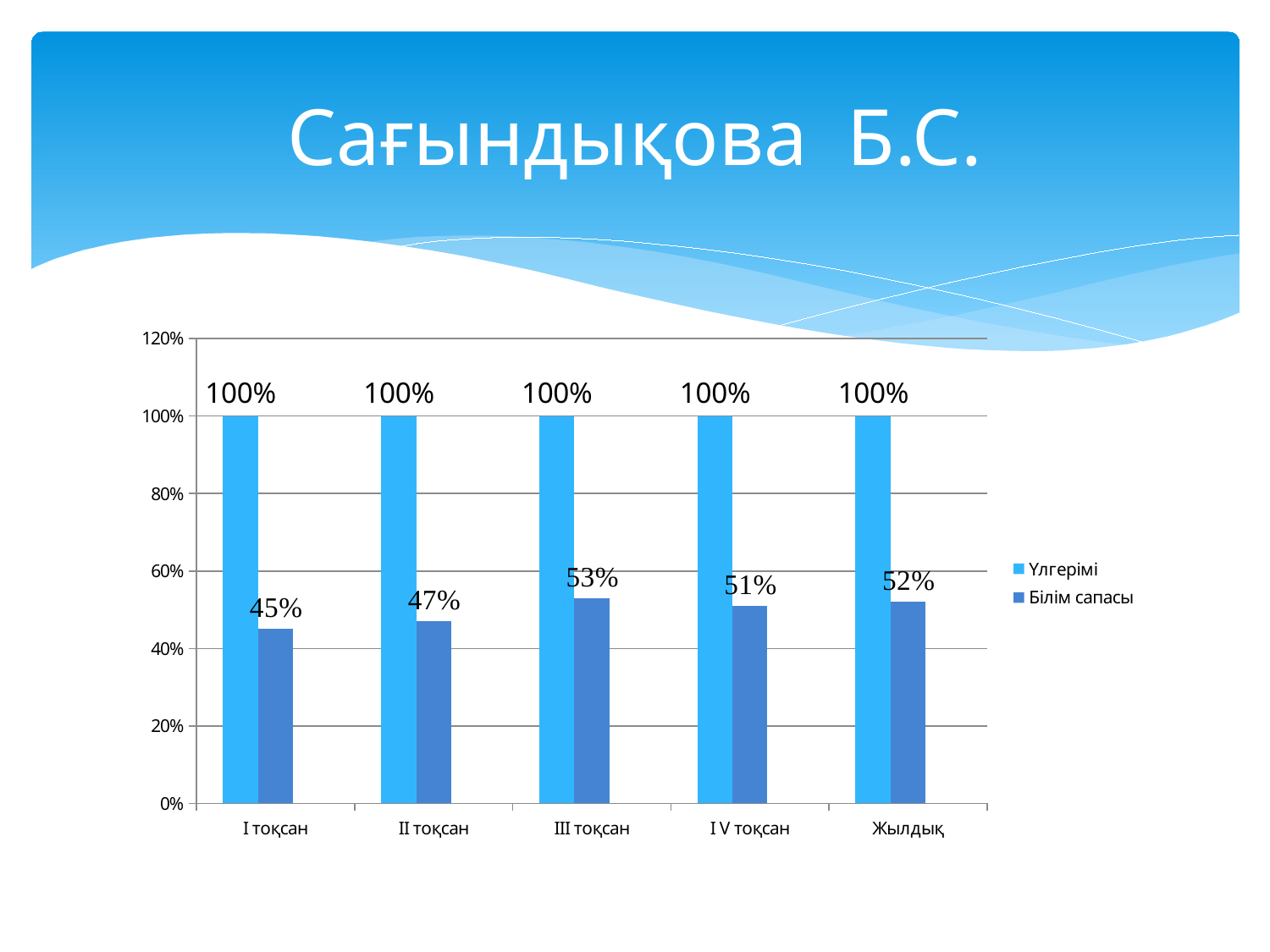
Which category has the lowest Білім сапасы value? I тоқсан What kind of chart is shown on the slide? Bar chart How many categories are shown on the x axis? 5 What is the value of Білім сапасы for I тоқсан? 45% Which category has the highest Білім сапасы value? III тоқсан What is the value of Білім сапасы for III тоқсан? 53% What is the difference between the Білім сапасы values for III тоқсан and I тоқсан? 8% What is the value of Үлгерімі for Жылдық? 100% Which is larger, the Білім сапасы value for II тоқсан or for I V тоқсан? I V тоқсан What are the two series names listed in the legend? Үлгерімі and Білім сапасы How many series does the legend list? 2 What is the value of Білім сапасы for Жылдық? 52%